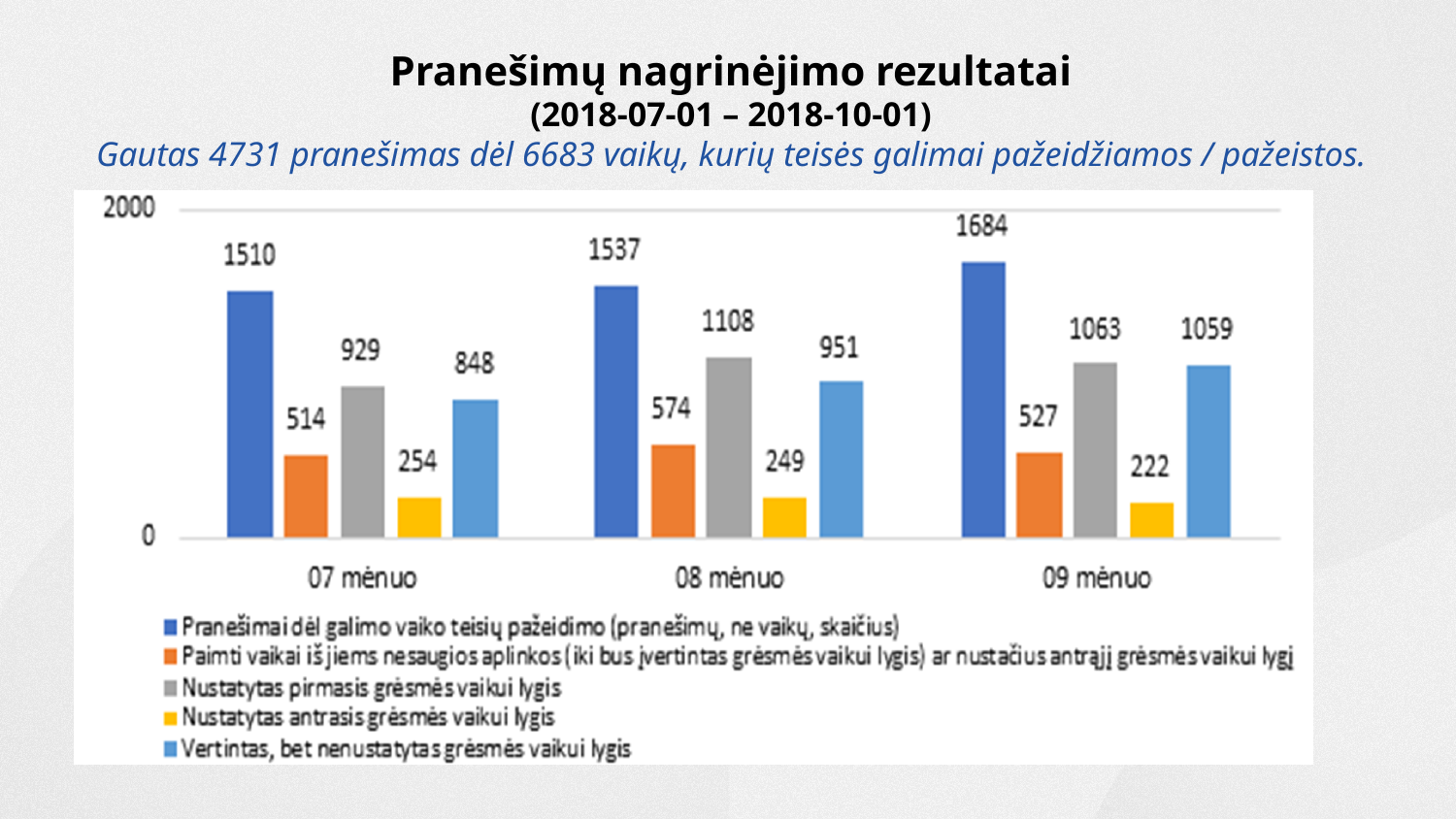
What is the value for 'Nustatytas pirmasis grėsmės vaikui lygis' in 08 mėnuo? 1108 What is the difference between the 'Pranešimai dėl galimo vaiko teisių pažeidimo' values for 09 mėnuo and 07 mėnuo? 174 What is the value for 'Pranešimai dėl galimo vaiko teisių pažeidimo' in 09 mėnuo? 1684 In which month is the value for 'Pranešimai dėl galimo vaiko teisių pažeidimo' highest? 09 mėnuo Does the value for 'Vertintas, bet nenustatytas grėsmės vaikui lygis' rise or fall from 07 mėnuo to 09 mėnuo? Rise How many months (categories) are shown on the x axis? 3 Which is larger in 08 mėnuo: 'Nustatytas pirmasis grėsmės vaikui lygis' or 'Vertintas, bet nenustatytas grėsmės vaikui lygis'? Nustatytas pirmasis grėsmės vaikui lygis What is the value for 'Nustatytas antrasis grėsmės vaikui lygis' in 07 mėnuo? 254 What kind of chart is shown on the slide? Bar chart What is the value for 'Vertintas, bet nenustatytas grėsmės vaikui lygis' in 09 mėnuo? 1059 In which month is the value for 'Nustatytas antrasis grėsmės vaikui lygis' lowest? 09 mėnuo How many series does the legend list? 5